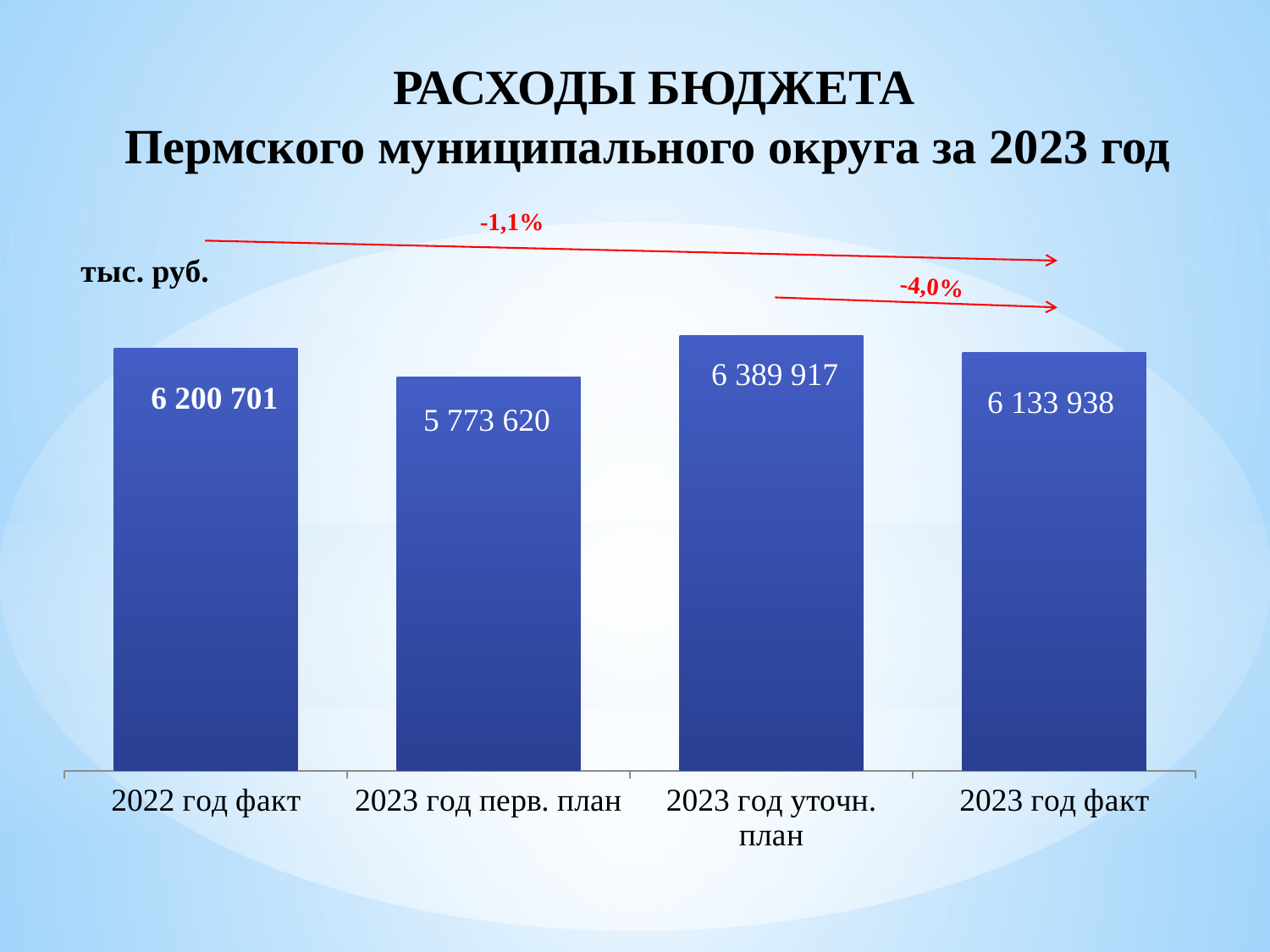
Which category has the highest value? 2023 год уточн. план What kind of chart is shown on the slide? bar chart How many categories are shown in the chart? 4 What is the value for 2023 год уточн. план? 6 389 917 Which is larger, the value for 2022 год факт or the value for 2023 год факт? 2022 год факт Which category has the lowest value? 2023 год перв. план What is the value for 2022 год факт? 6 200 701 What is the difference between the values for 2022 год факт and 2023 год перв. план? 427 081 What is the difference between the values for 2023 год уточн. план and 2023 год факт? 255 979 What unit of measurement is indicated for the chart values? тыс. руб. What is the value for 2023 год перв. план? 5 773 620 What is the value for 2023 год факт? 6 133 938